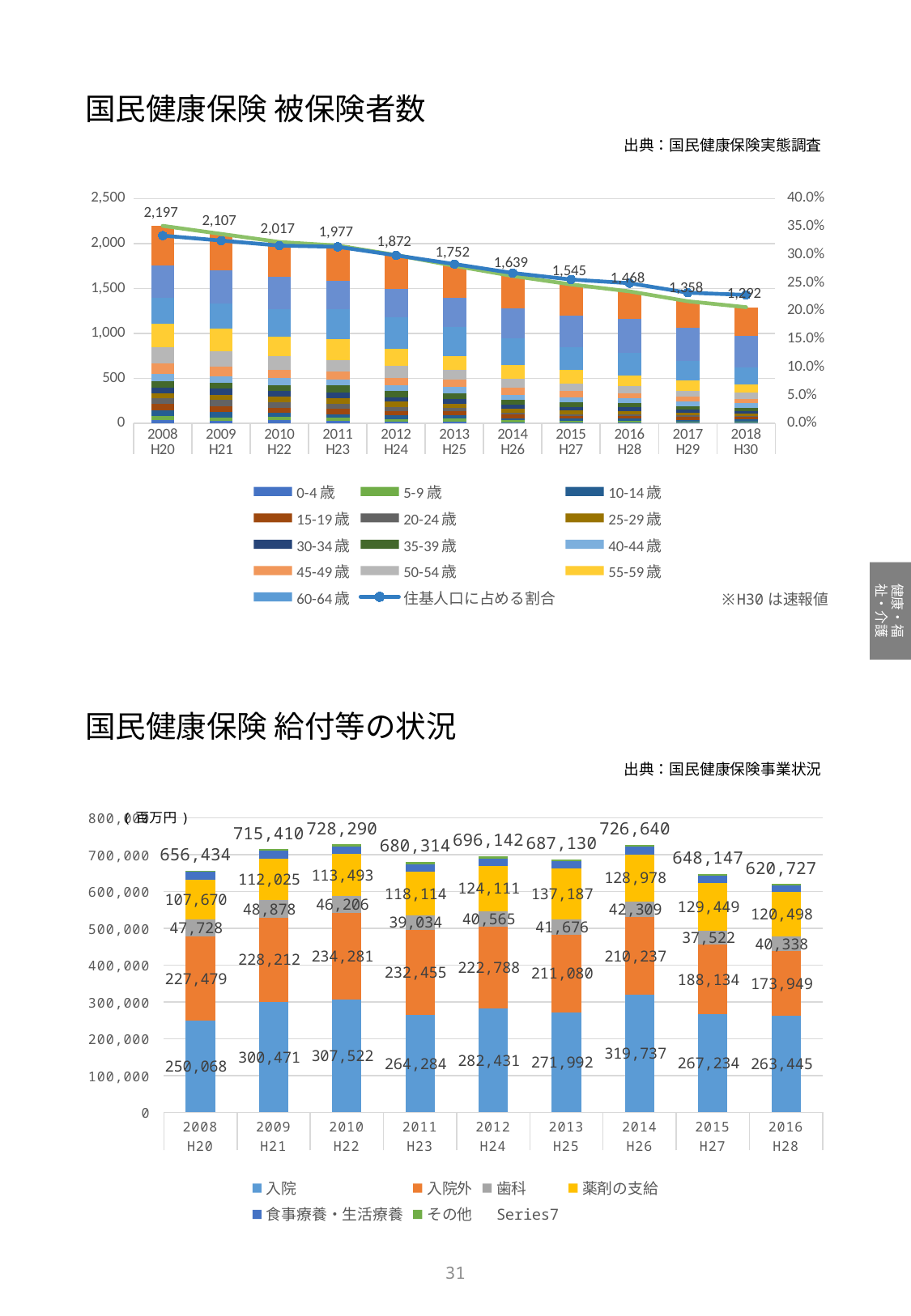
In the top chart (国民健康保険 被保険者数), how many years are shown on the x axis? 11 In the top chart (国民健康保険 被保険者数), what is the total labeled for 2018 (H30)? 1,292 In the top chart (国民健康保険 被保険者数), do the bar totals rise or fall from 2008 to 2018? fall In the bottom chart (国民健康保険 給付等の状況), what is the 薬剤の支給 value for 2013 (H25)? 137,187 In the top chart (国民健康保険 被保険者数), what is the difference between the 2008 total (2,197) and the 2013 total (1,752)? 445 In the bottom chart (国民健康保険 給付等の状況), which is larger: the 入院外 value for 2008 (H20) or for 2016 (H28)? 2008 (H20) In the bottom chart (国民健康保険 給付等の状況), which year has the highest total labeled above the bar? 2010 (H22) In the bottom chart (国民健康保険 給付等の状況), how many entries does the legend list? 7 In the top chart (国民健康保険 被保険者数), what is the total number of insured persons labeled for 2008 (H20)? 2,197 In the bottom chart (国民健康保険 給付等の状況), what is the 入院 value for 2014 (H26)? 319,737 In the top chart (国民健康保険 被保険者数), which year has the highest total number of insured persons? 2008 (H20) In the bottom chart (国民健康保険 給付等の状況), which year has the lowest total labeled above the bar? 2016 (H28)